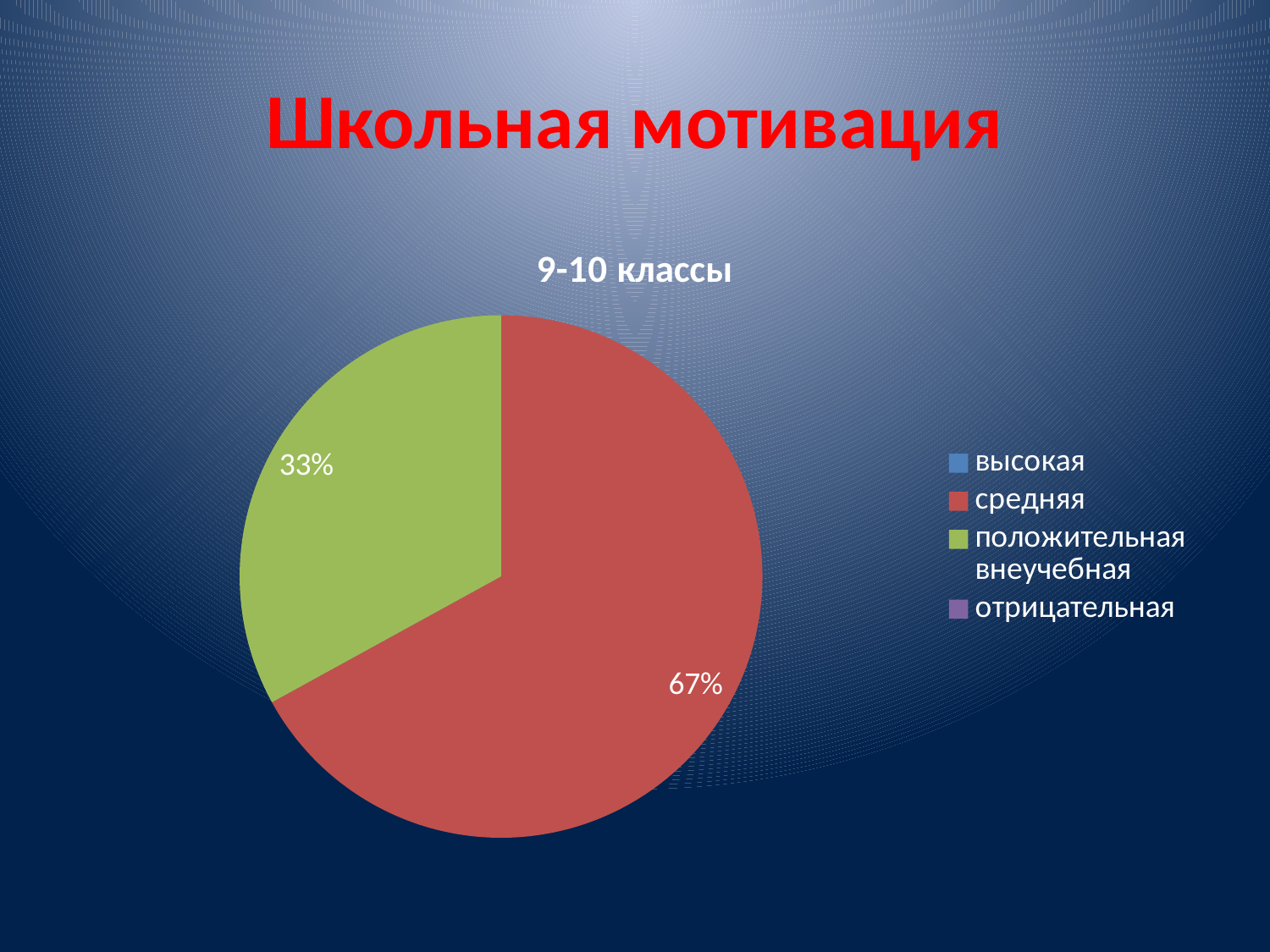
Which of the two visible slices is larger: 'средняя' or 'положительная внеучебная'? средняя What share of the pie does the 'средняя' slice take? 67% What type of chart is shown on the slide? pie chart How many slices are visible in the pie? 2 Which category has the largest slice of the pie? средняя What colour is the 'средняя' slice? red What share of the pie does the 'положительная внеучебная' slice take? 33% What is the difference in percentage points between the 'средняя' and 'положительная внеучебная' slices? 34 What is the title of the chart? 9-10 классы Is the share for 'положительная внеучебная' greater or less than 50%? less How many entries does the legend list? 4